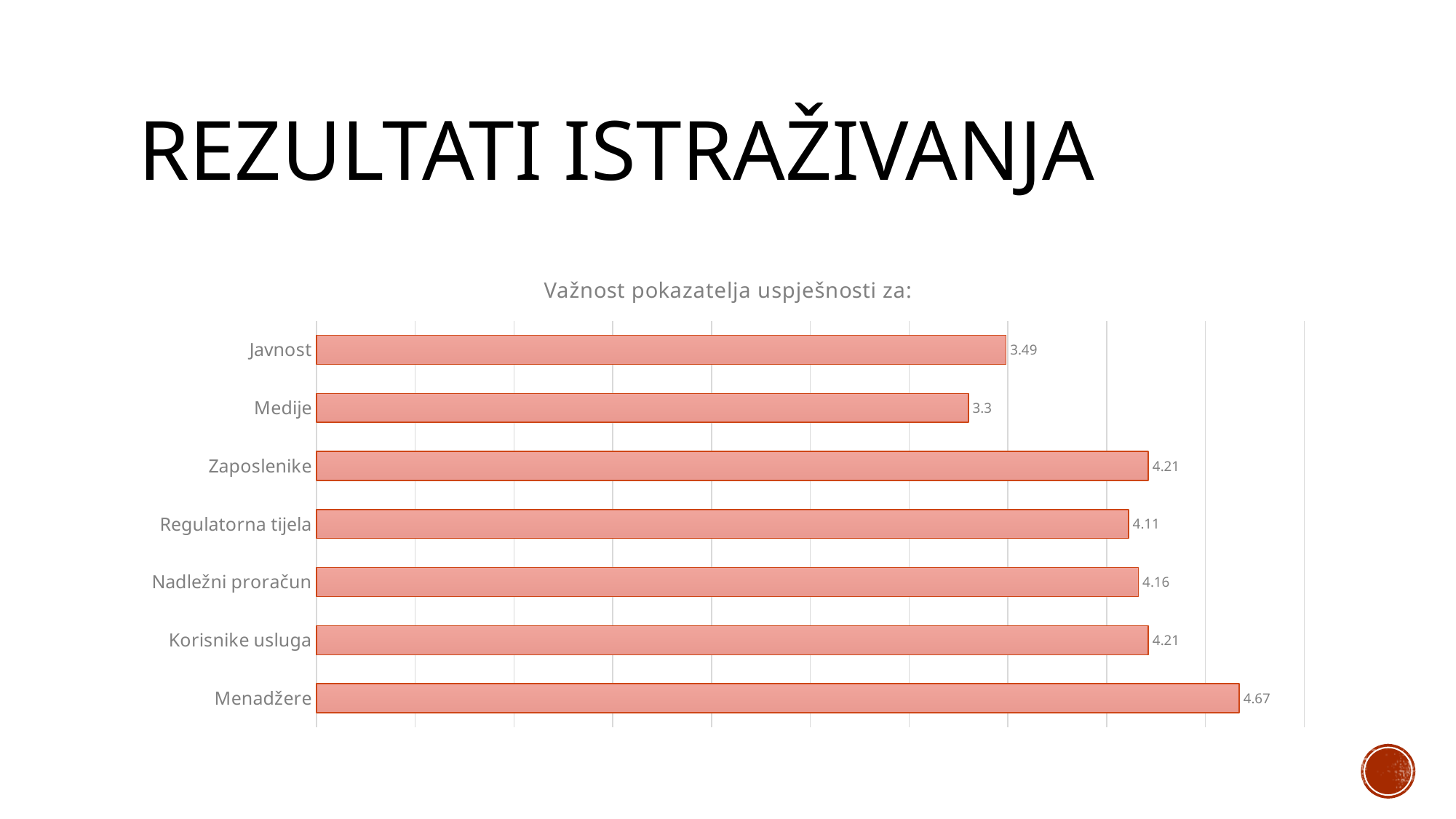
How many categories are shown in the chart? 7 What is the title of the chart? Važnost pokazatelja uspješnosti za: What kind of chart is shown on the slide? Bar chart What is the difference between the values for Menadžere and Javnost? 1.18 What is the value for Medije? 3.3 What is the value for Nadležni proračun? 4.16 Which is larger, the value for Javnost or the value for Medije? Javnost What is the difference between the values for Zaposlenike and Regulatorna tijela? 0.1 What is the value for Menadžere? 4.67 Which category has the highest value? Menadžere Which category has the lowest value? Medije What is the value for Regulatorna tijela? 4.11